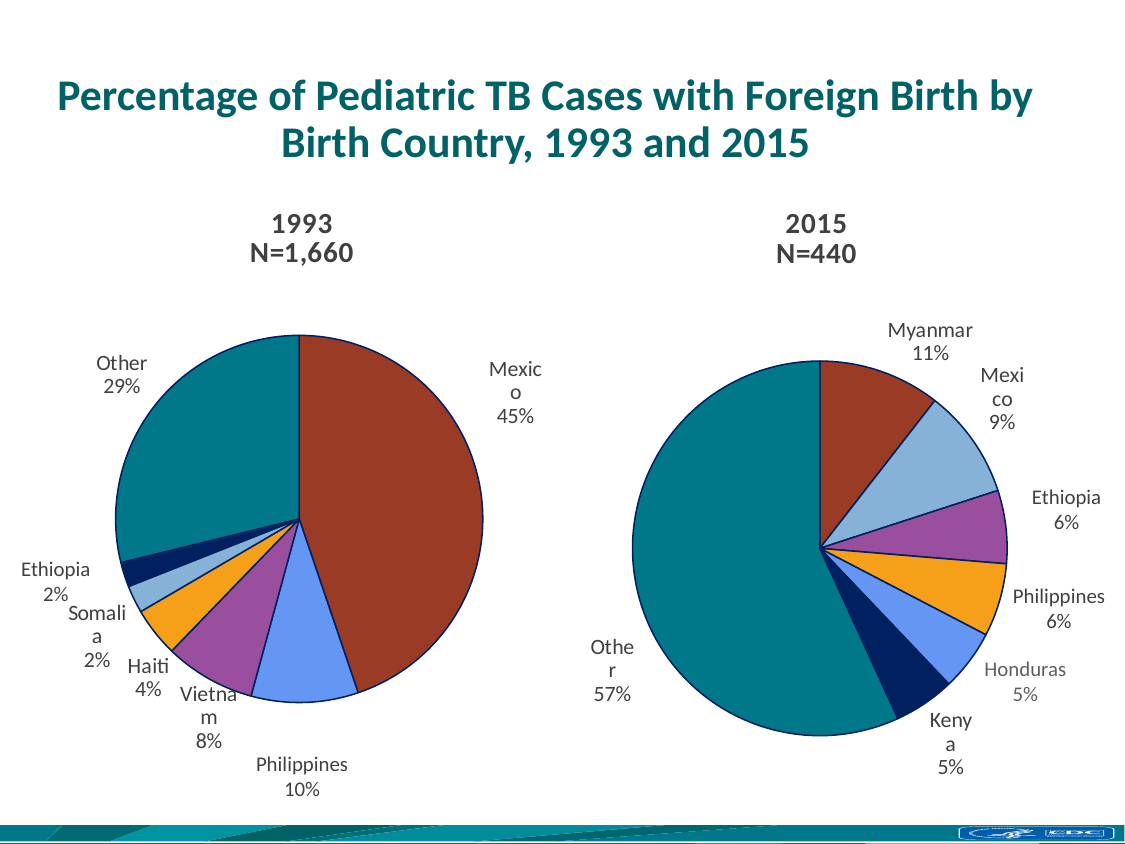
In the 1993 pie chart, which birth country has the largest share? Mexico In the 1993 pie chart, what percentage of pediatric TB cases with foreign birth were born in Mexico? 45% In the 2015 pie chart, what share of cases is labeled Myanmar? 11% How many slices does the 1993 pie chart have? 7 Which is larger in the 1993 pie chart: the share for Philippines or the share for Vietnam? Philippines What is the N value shown for the 2015 pie chart? N=440 In the 1993 pie chart, what is the difference in percentage points between Mexico and Other? 16 How many slices does the 2015 pie chart have? 7 In the 2015 pie chart, what is the difference in percentage points between Myanmar and Mexico? 2 What type of chart is used on this slide? Pie chart In the 2015 pie chart, what percentage of cases were born in Honduras? 5% In the 2015 pie chart, which labeled slice is the largest? Other